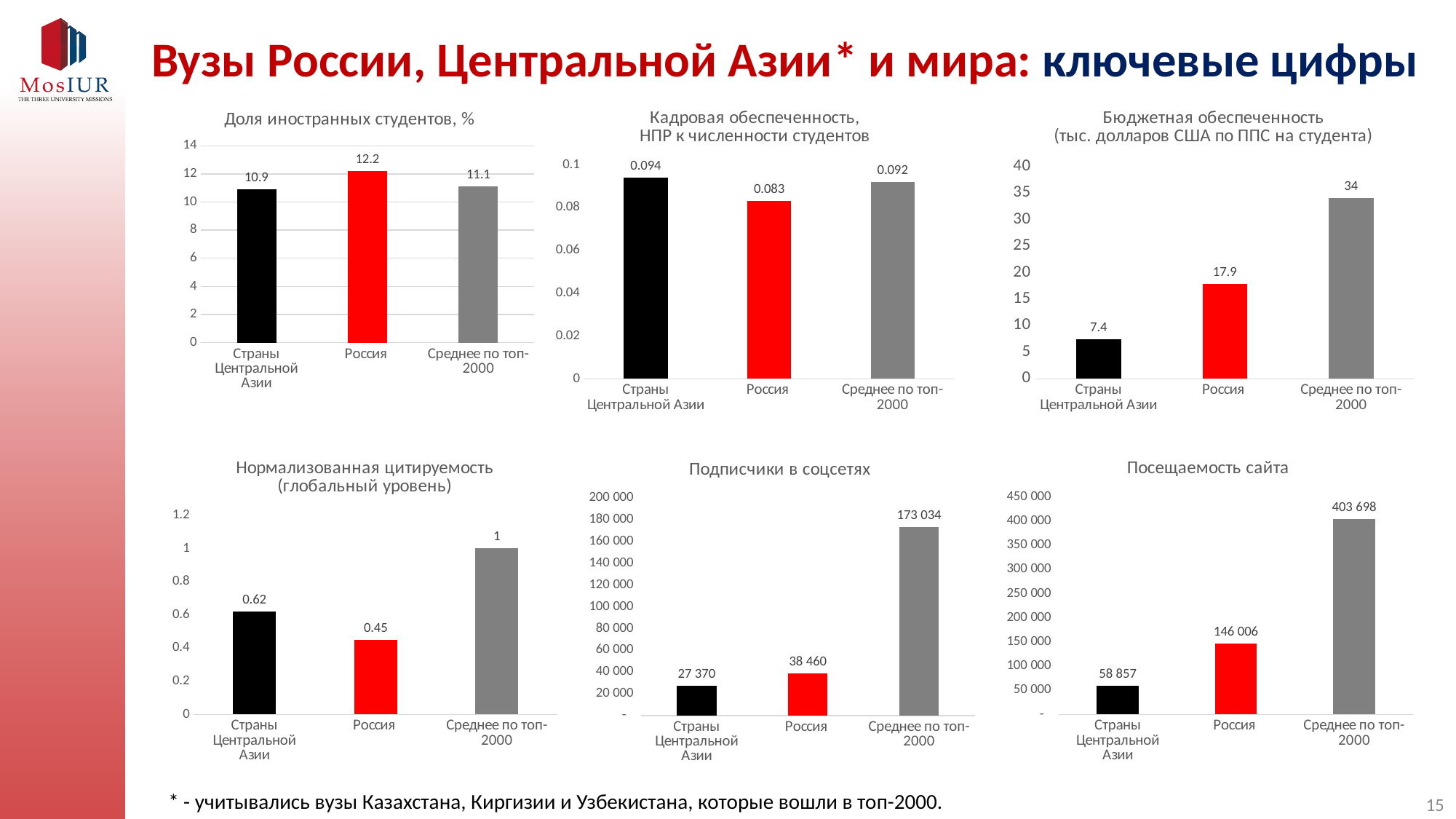
In the chart titled "Доля иностранных студентов, %", which category has the lowest value? Страны Центральной Азии In the chart titled "Доля иностранных студентов, %", what is the value for Россия? 12.2 In the chart titled "Кадровая обеспеченность, НПР к численности студентов", what is the value for Среднее по топ-2000? 0.092 In the chart titled "Нормализованная цитируемость (глобальный уровень)", which is larger, the value for Страны Центральной Азии or the value for Россия? Страны Центральной Азии How many charts are shown on the slide? 6 In the chart titled "Бюджетная обеспеченность", is the value for Страны Центральной Азии greater or less than 10? less In the chart titled "Посещаемость сайта", what is the value for Россия? 146 006 In the chart titled "Нормализованная цитируемость (глобальный уровень)", what is the value for Россия? 0.45 In the chart titled "Кадровая обеспеченность, НПР к численности студентов", which category has the highest value? Страны Центральной Азии In the chart titled "Подписчики в соцсетях", what is the value for Среднее по топ-2000? 173 034 In the chart titled "Бюджетная обеспеченность", what is the difference between the value for Среднее по топ-2000 and the value for Россия? 16.1 In the chart titled "Подписчики в соцсетях", what is the difference between the value for Россия and the value for Страны Центральной Азии? 11 090